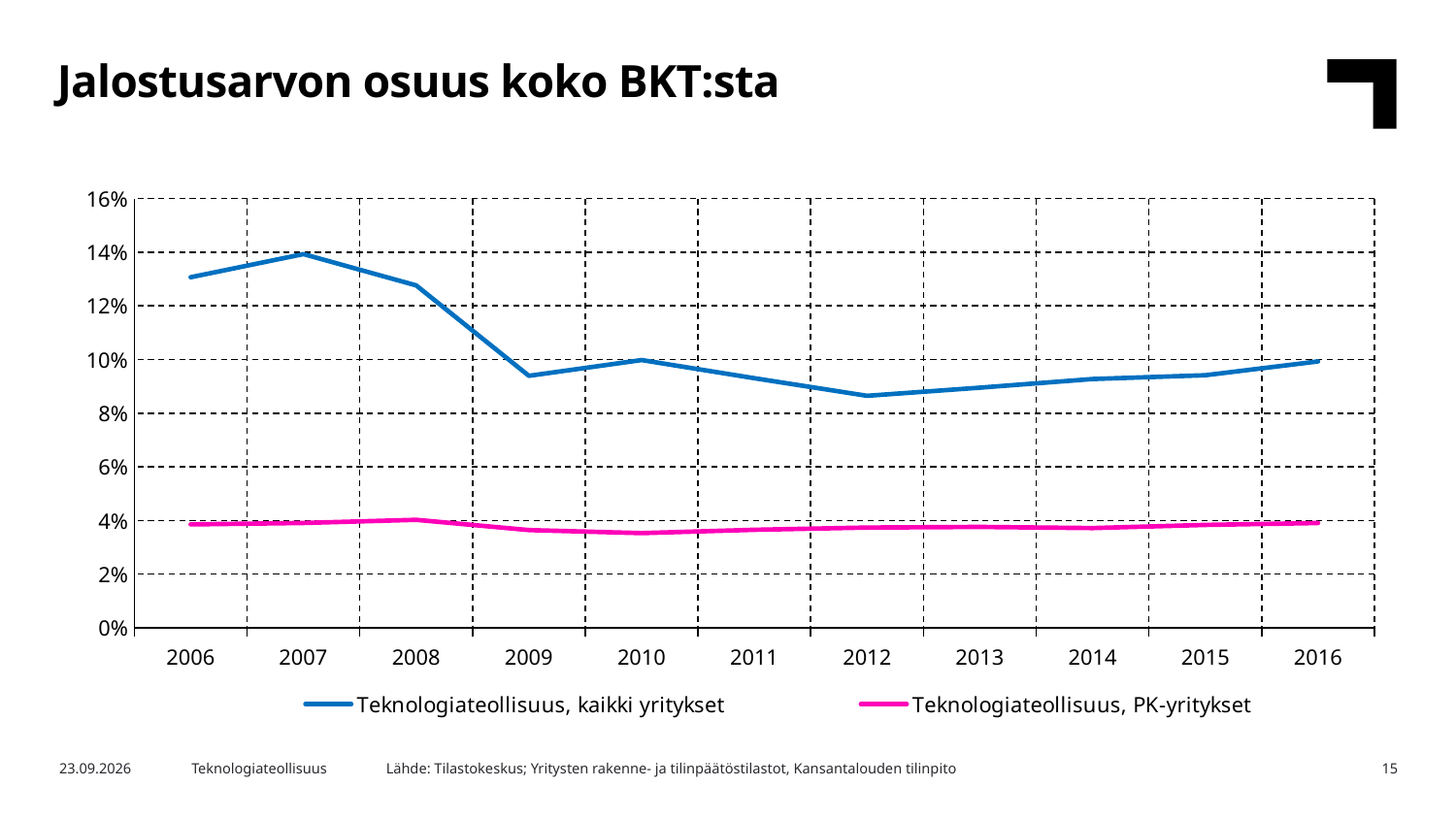
Is the 2009 value for Teknologiateollisuus, kaikki yritykset greater or less than 10%? less Is the 2006 value for Teknologiateollisuus, kaikki yritykset greater or less than 12%? greater What is the title of the chart? Jalostusarvon osuus koko BKT:sta Is the 2008 value for Teknologiateollisuus, PK-yritykset greater or less than 6%? less How many years are plotted along the x axis? 11 Which series has the higher value in 2010? Teknologiateollisuus, kaikki yritykset How many series does the legend list? 2 Which year has the larger value for Teknologiateollisuus, kaikki yritykset: 2007 or 2016? 2007 In which year is the value for Teknologiateollisuus, kaikki yritykset lowest? 2012 What kind of chart is shown on the slide? Line chart In which year is the value for Teknologiateollisuus, kaikki yritykset highest? 2007 Does the value for Teknologiateollisuus, kaikki yritykset rise or fall from 2007 to 2009? fall